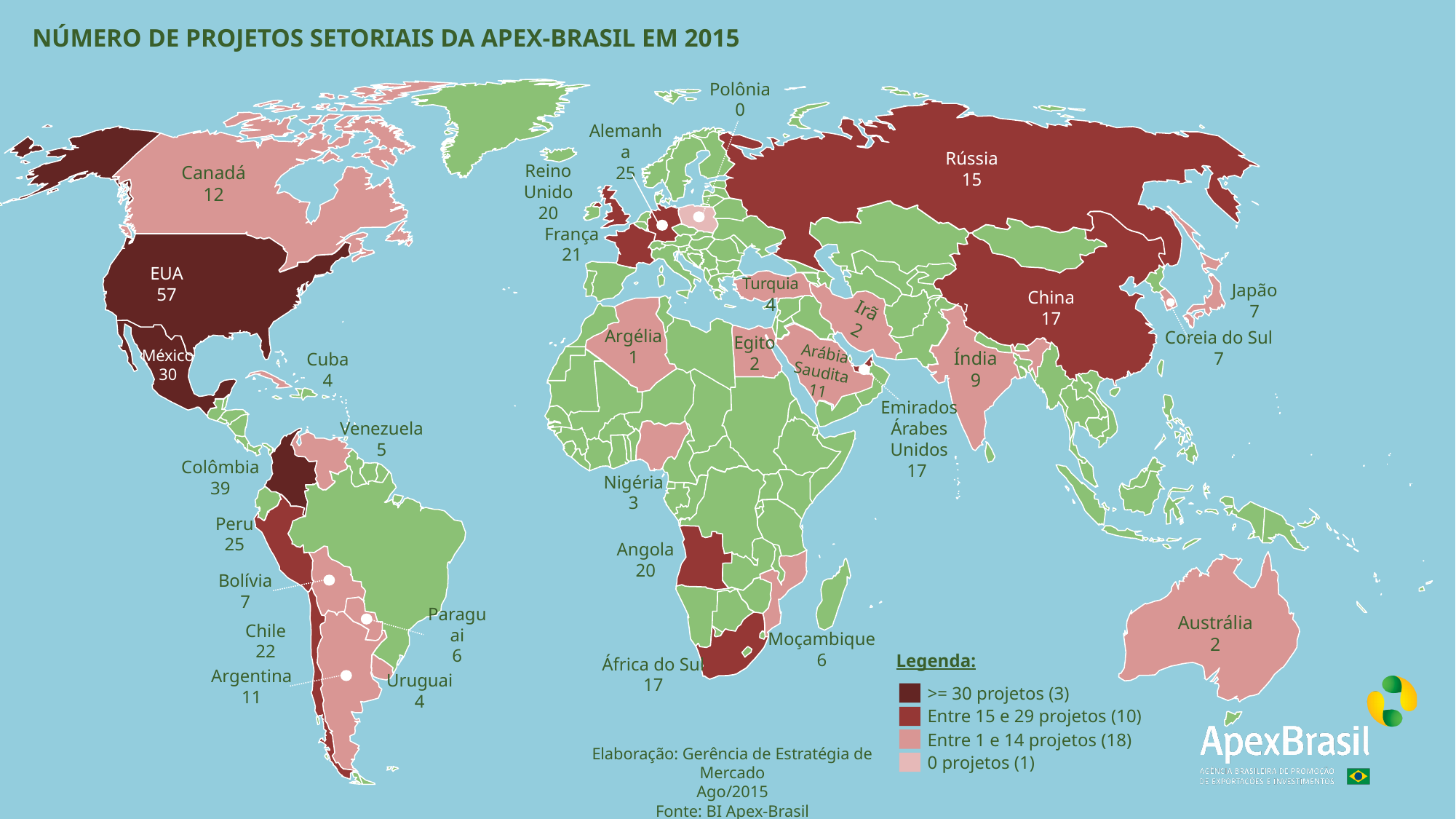
What is the title of the chart? NÚMERO DE PROJETOS SETORIAIS DA APEX-BRASIL EM 2015 How many sectoral projects does the map show for EUA? 57 What is the value shown for Colômbia? 39 What is the difference between the values for EUA and Colômbia? 18 Which labelled country has the lowest number of projects on the map? Polônia According to the legend, how many countries have 30 or more projects? 3 What kind of chart is shown on the slide? Map chart What is the difference between the values for Alemanha and Reino Unido? 5 Which has a higher value, China or Canadá? China Which country has the highest number of projects on the map? EUA What is the value shown for Rússia? 15 How many categories does the legend list? 4